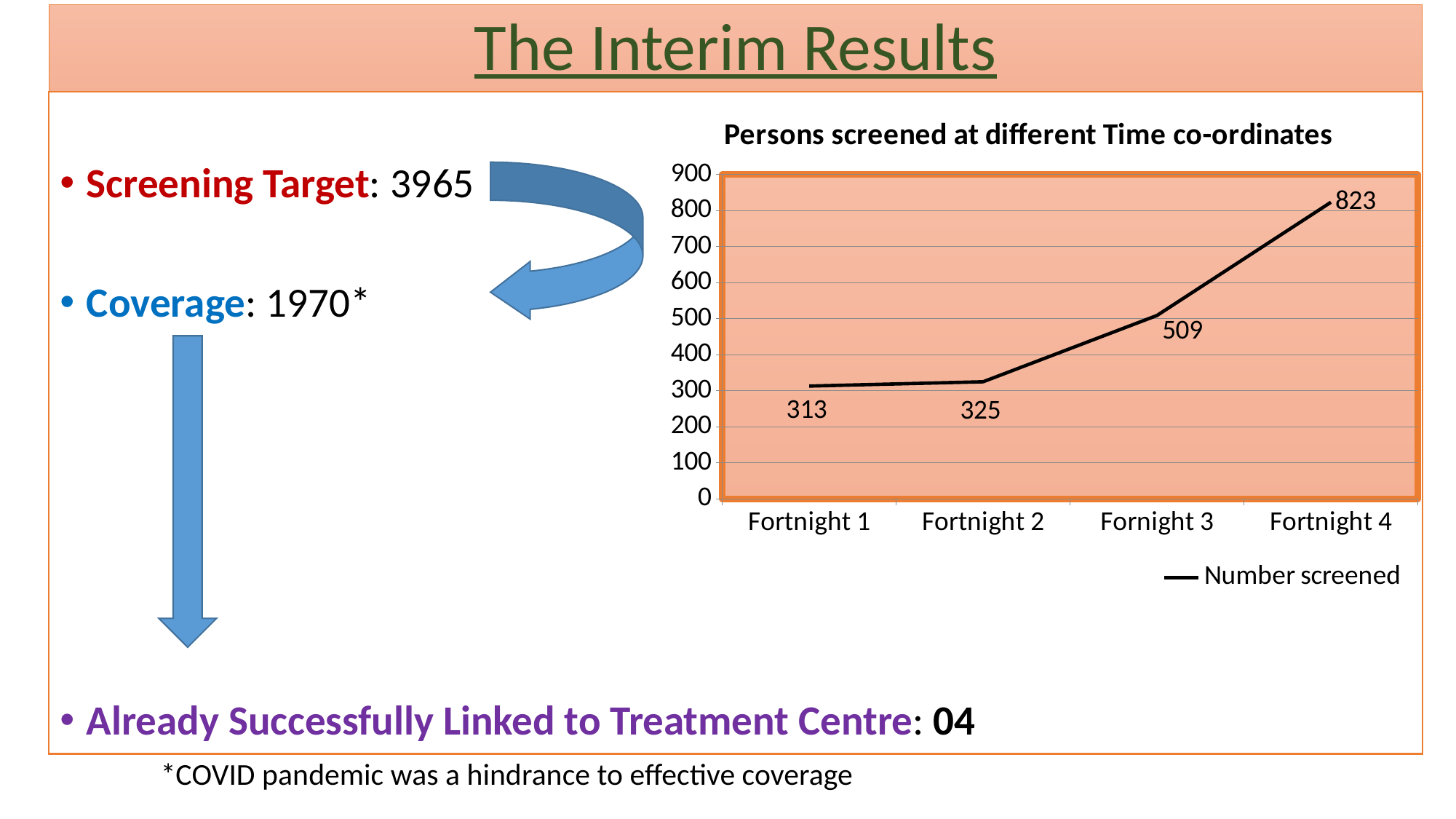
Which fortnight has the lowest number screened? Fortnight 1 What is the number screened in Fornight 3? 509 Which fortnight has the highest number screened? Fortnight 4 How many time points are plotted on the chart? 4 What is the number screened in Fortnight 2? 325 What is the difference between the number screened in Fortnight 4 and Fornight 3? 314 What is the title of the chart? Persons screened at different Time co-ordinates Does the number screened rise or fall from Fortnight 1 to Fortnight 4? rise What is the number screened in Fortnight 4? 823 What kind of chart is shown on the slide? line chart What is the number screened in Fortnight 1? 313 Which is larger, the number screened in Fortnight 2 or Fornight 3? Fornight 3